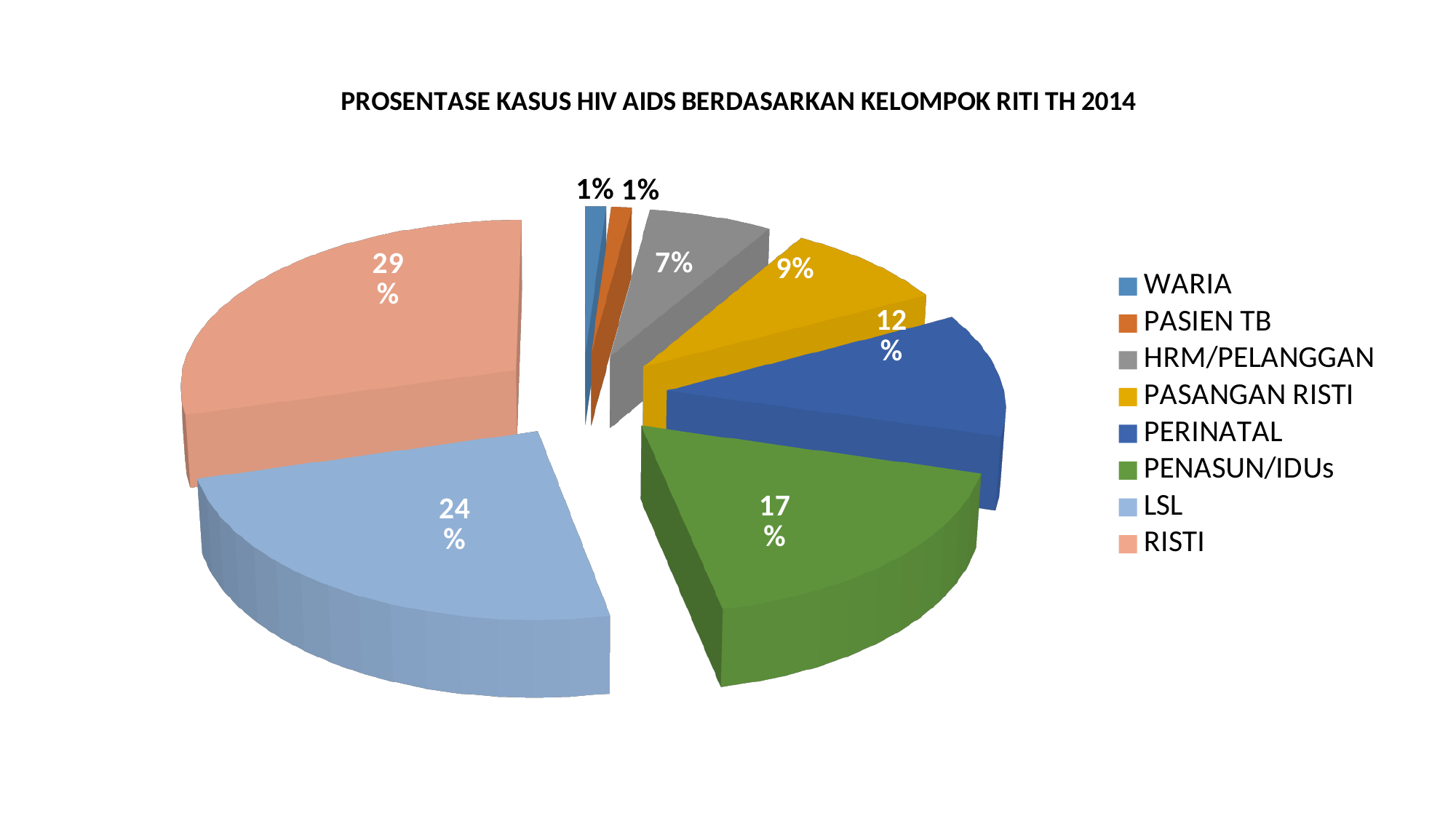
Which category has the largest share of the pie? RISTI What percentage is shown for RISTI? 29% How many categories does the legend list? 8 What is the difference in percentage points between RISTI and LSL? 5 What percentage is shown for PENASUN/IDUs? 17% What kind of chart is shown on the slide? Pie chart What is the title of the chart? PROSENTASE KASUS HIV AIDS BERDASARKAN KELOMPOK RITI TH 2014 What percentage is shown for PERINATAL? 12% What colour is the slice for PENASUN/IDUs? Green What percentage is shown for LSL? 24% What percentage is shown for HRM/PELANGGAN? 7% Which is larger, the share for PASANGAN RISTI or the share for PERINATAL? PERINATAL